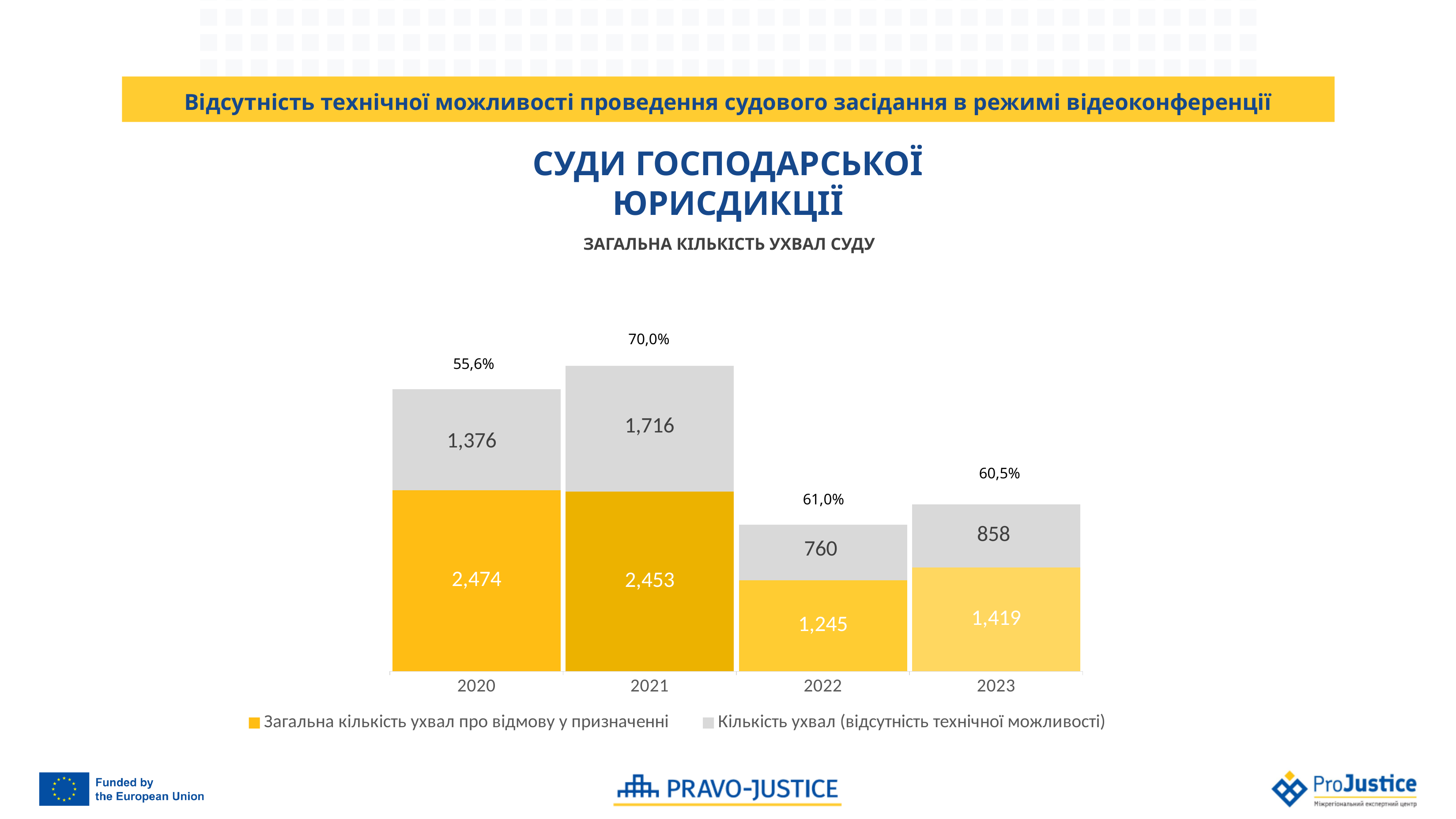
What percentage label is shown above the bar for 2022? 61,0% What is the value of the 'Загальна кількість ухвал про відмову у призначенні' series for 2020? 2,474 What kind of chart is shown on the slide? Stacked bar chart How many years are shown on the x axis of the chart? 4 Which year has the lowest value for the 'Загальна кількість ухвал про відмову у призначенні' series? 2022 What is the difference between the 'Загальна кількість ухвал про відмову у призначенні' values for 2020 and 2021? 21 Which is larger: the 'Кількість ухвал (відсутність технічної можливості)' value for 2022 or for 2023? 2023 Which year has the highest value for the 'Кількість ухвал (відсутність технічної можливості)' series? 2021 What is the value of the 'Кількість ухвал (відсутність технічної можливості)' series for 2023? 858 What is the total of the stacked bar for 2022? 2,005 How many series does the chart legend list? 2 What is the value of the 'Кількість ухвал (відсутність технічної можливості)' series for 2021? 1,716